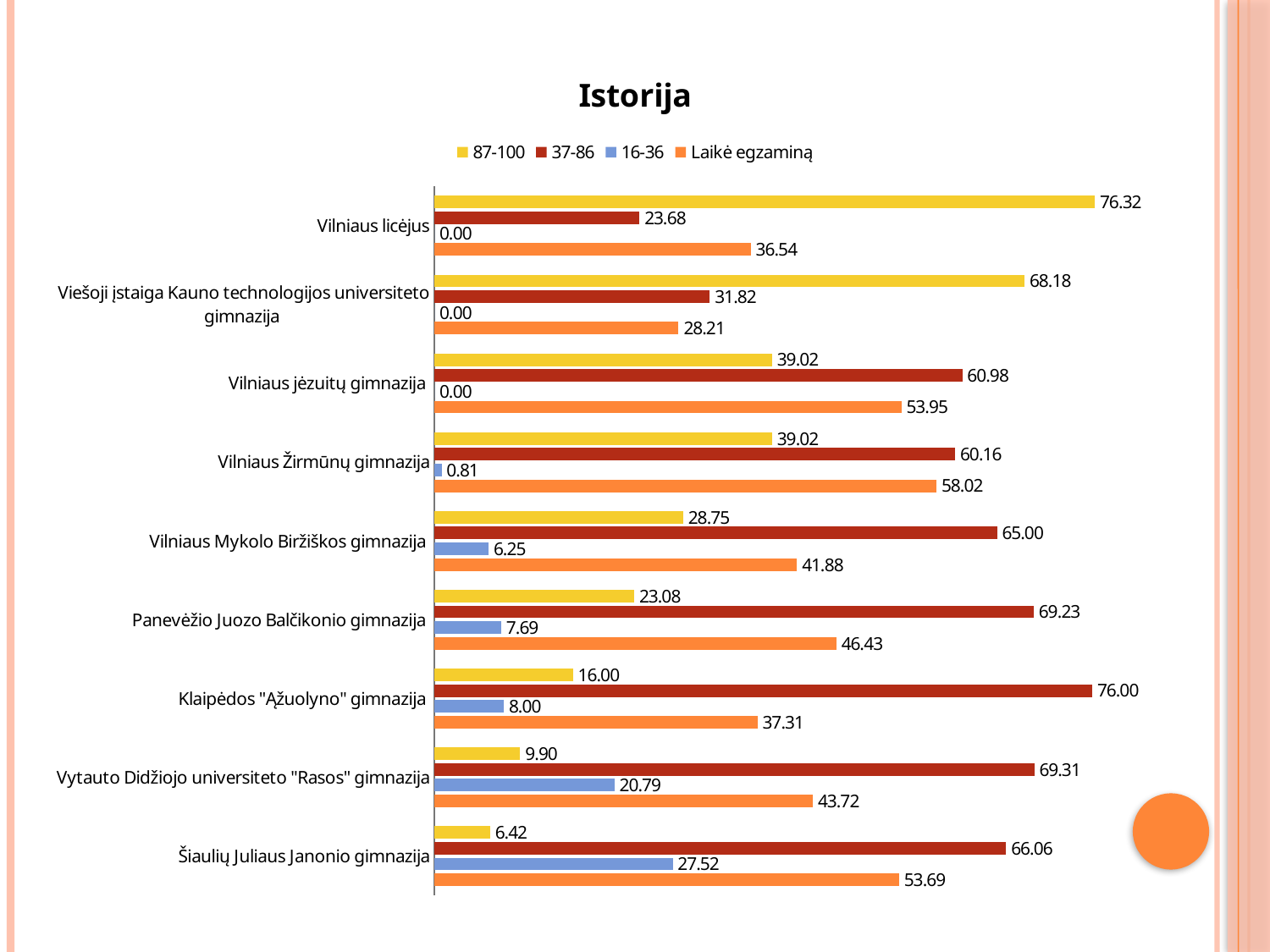
How many series does the legend list? 4 What is the title of the chart? Istorija What is the value of the 87-100 series for Vilniaus licėjus? 76.32 What kind of chart is shown on the slide? Bar chart What is the value of the 37-86 series for Klaipėdos "Ąžuolyno" gimnazija? 76.00 Which school has the lowest value in the 87-100 series? Šiaulių Juliaus Janonio gimnazija For the 16-36 series, which is larger: Vytauto Didžiojo universiteto "Rasos" gimnazija or Šiaulių Juliaus Janonio gimnazija? Šiaulių Juliaus Janonio gimnazija Which school has the highest value in the 87-100 series? Vilniaus licėjus Which school has the highest value in the Laikė egzaminą series? Vilniaus Žirmūnų gimnazija How many schools are shown on the chart? 9 For Vilniaus licėjus, what is the difference between the 87-100 value and the 37-86 value? 52.64 What is the value of the 16-36 series for Šiaulių Juliaus Janonio gimnazija? 27.52